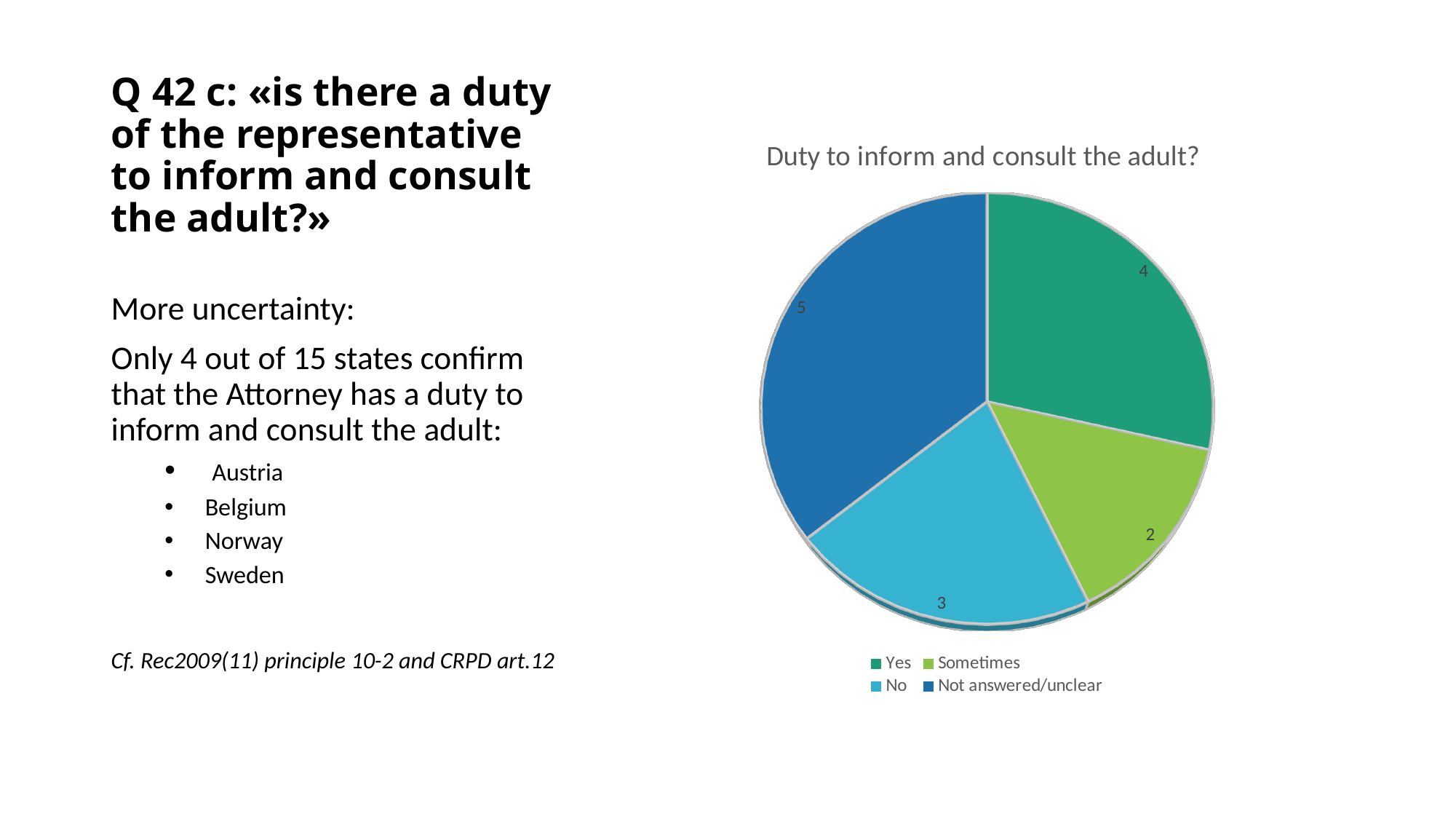
Which category has the largest slice? Not answered/unclear How many slices does the pie chart have? 4 What is the difference between the 'Not answered/unclear' value and the 'Yes' value? 1 Which is larger, the 'No' slice or the 'Sometimes' slice? No What is the value for the 'Not answered/unclear' slice? 5 What is the value for the 'Sometimes' slice? 2 How many entries does the legend list? 4 What is the title of the chart? Duty to inform and consult the adult? What is the value for the 'No' slice? 3 What type of chart is shown on the slide? pie chart Which category has the smallest slice? Sometimes What is the value for the 'Yes' slice? 4